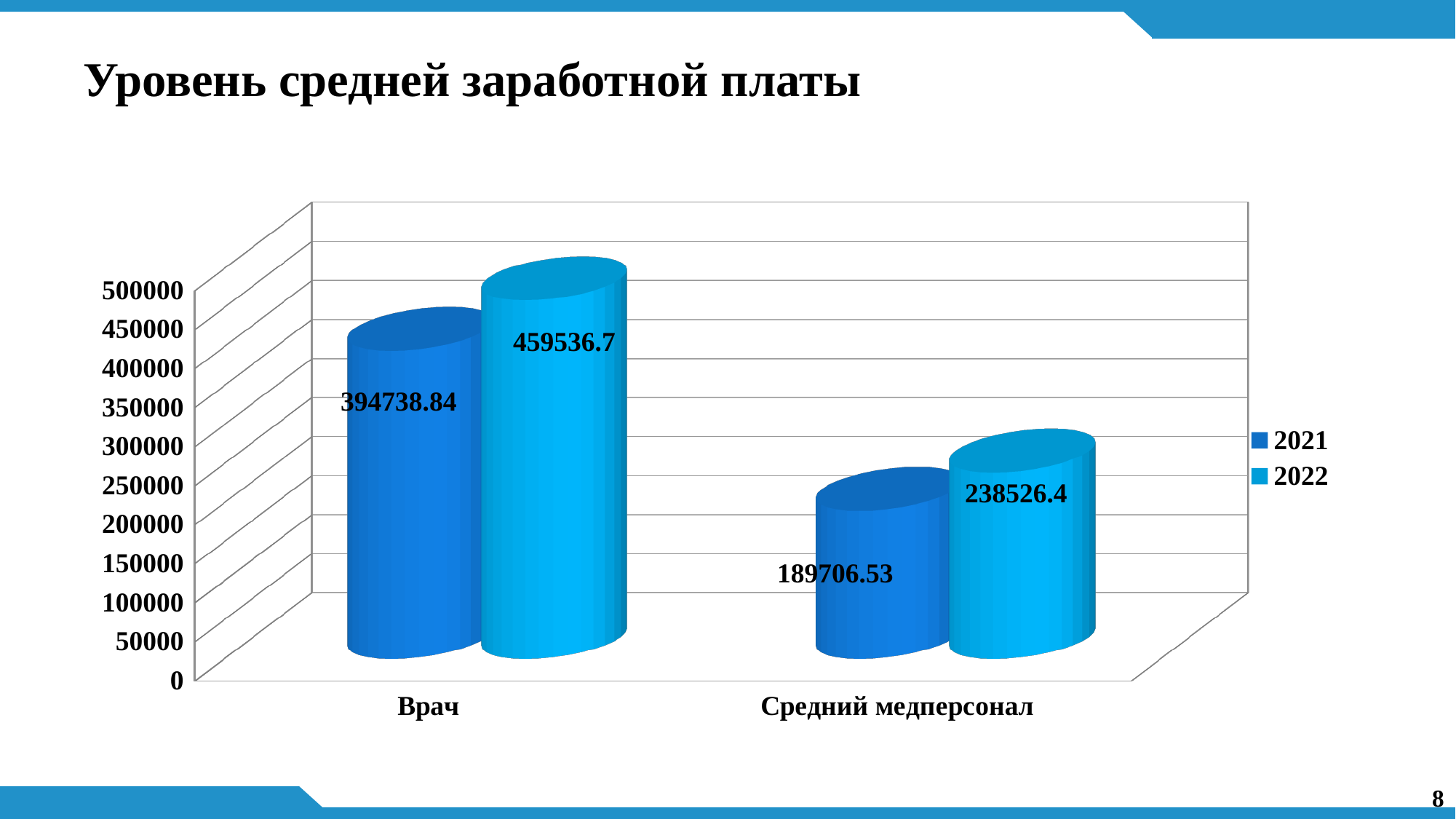
How many series does the legend list? 2 What kind of chart is shown on the slide? Bar chart What is the difference between the 2022 and 2021 values for Средний медперсонал? 48819.87 What is the value for Врач in 2022? 459536.7 Which category has the highest value in 2022? Врач What is the value for Средний медперсонал in 2021? 189706.53 Which is larger: the 2021 value for Врач or the 2022 value for Средний медперсонал? 2021 value for Врач What is the difference between the 2022 and 2021 values for Врач? 64797.86 What is the value for Врач in 2021? 394738.84 How many categories are shown on the x axis? 2 What is the value for Средний медперсонал in 2022? 238526.4 Which category has the lowest value in 2021? Средний медперсонал